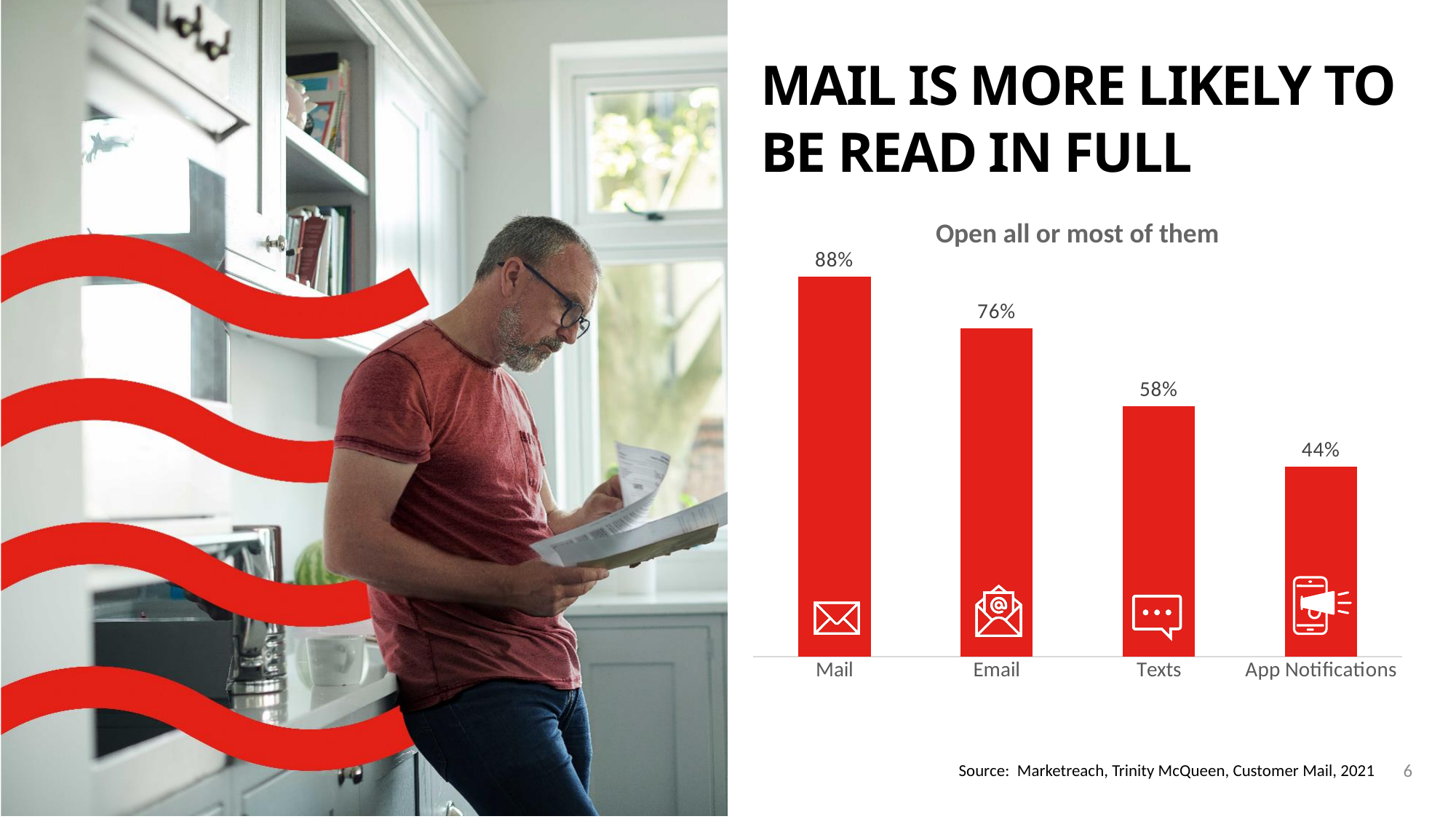
What percentage of people open all or most of their Mail? 88% How many channels are shown on the chart? 4 Which channel has the lowest value on the chart? App Notifications Which is larger, the value for Email or the value for Texts? Email What is the difference between the values for Mail and Email? 12% What is the value shown for App Notifications? 44% What is the value shown for Texts? 58% Which channel has the highest share of people opening all or most of them? Mail What kind of chart is shown on the slide? Bar chart What is the difference between the values for Texts and App Notifications? 14% What is the value shown for Email? 76% What is the title of the chart? Open all or most of them